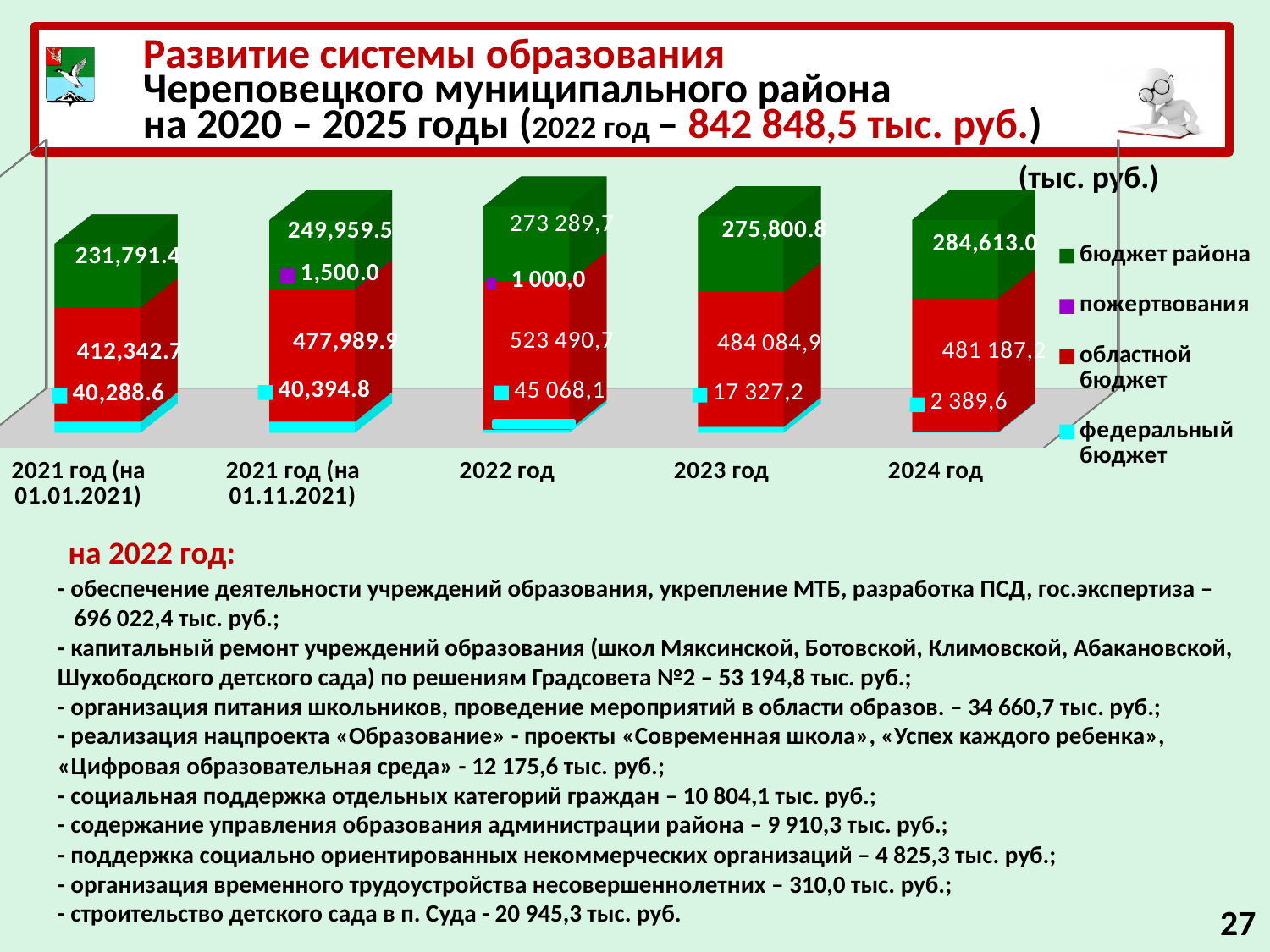
How many series does the legend list? 4 What is the total of the stacked bar for 2021 год (на 01.01.2021)? 684,422.7 What kind of chart is shown on the slide? Stacked bar chart What is the difference in бюджет района between 2024 год and 2023 год? 8,812.2 How many categories (years) are shown on the x axis? 5 Which is larger: областной бюджет for 2021 год (на 01.01.2021) or for 2021 год (на 01.11.2021)? 2021 год (на 01.11.2021) What is the value of бюджет района for 2021 год (на 01.01.2021)? 231,791.4 What is the value of федеральный бюджет for 2024 год? 2 389,6 Which year has the lowest value for федеральный бюджет? 2024 год What is the value of областной бюджет for 2023 год? 484 084,9 What is the value of пожертвования for 2021 год (на 01.11.2021)? 1,500.0